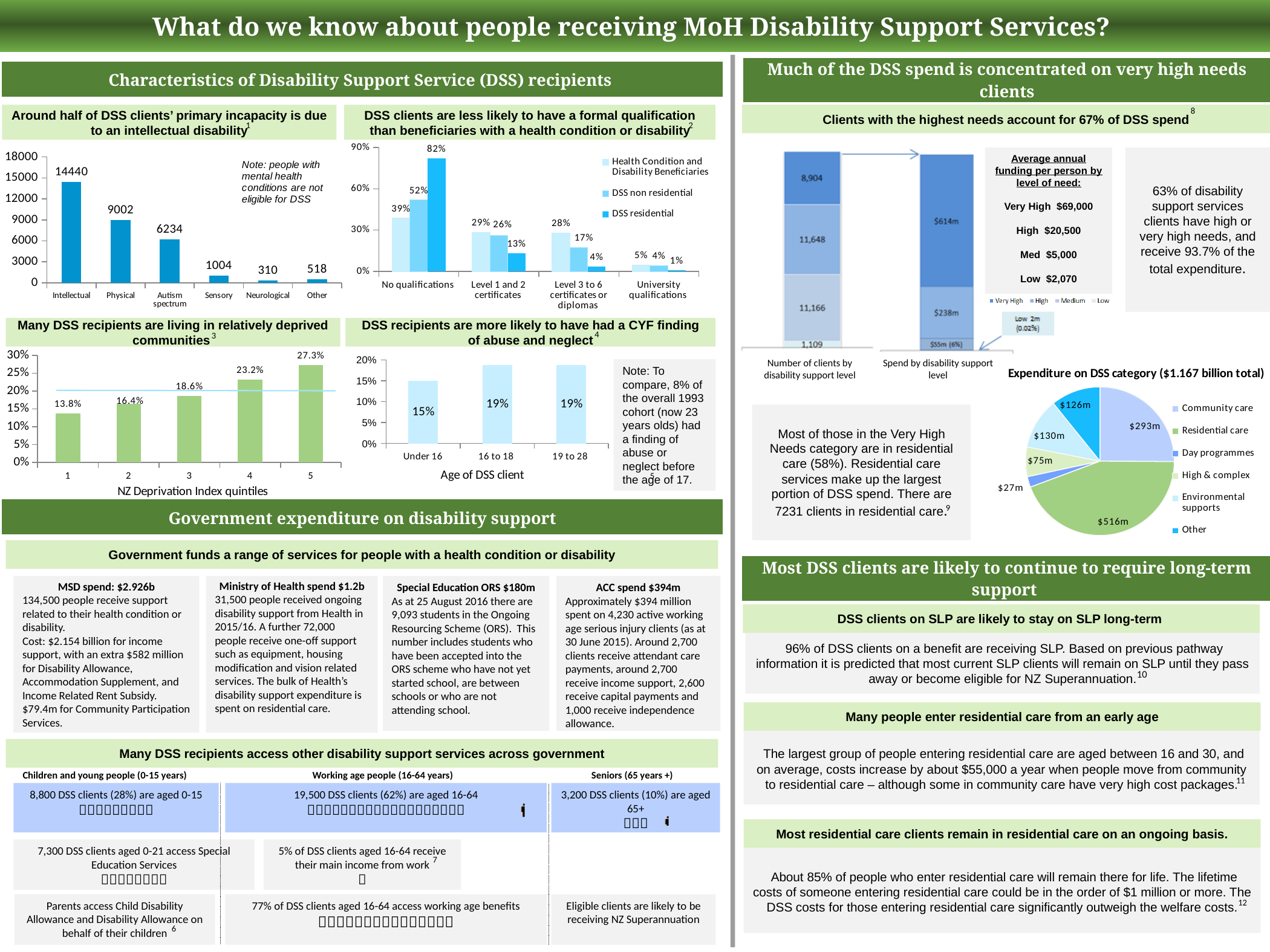
In the chart 'DSS clients are less likely to have a formal qualification', what is the value for DSS non residential clients with Level 3 to 6 certificates or diplomas? 17% How many series does the legend list in the chart 'DSS clients are less likely to have a formal qualification'? 3 What kind of chart is 'Expenditure on DSS category ($1.167 billion total)'? pie chart In the chart 'Around half of DSS clients' primary incapacity is due to an intellectual disability', what is the value for Physical? 9002 In the pie chart 'Expenditure on DSS category', what is the value of the Residential care slice? $516m In the chart 'Many DSS recipients are living in relatively deprived communities', do the values rise or fall from quintile 1 to quintile 5? rise In the chart 'Many DSS recipients are living in relatively deprived communities', what is the value for quintile 5? 27.3% In the stacked bar 'Number of clients by disability support level', what is the value of the Very High segment? 8,904 In the chart 'Around half of DSS clients' primary incapacity is due to an intellectual disability', what is the difference between the Intellectual and Autism spectrum values? 8206 In the chart 'DSS clients are less likely to have a formal qualification', what percentage of DSS residential clients have no qualifications? 82% In the chart 'Around half of DSS clients' primary incapacity is due to an intellectual disability', which category has the lowest value? Neurological In the chart 'DSS recipients are more likely to have had a CYF finding of abuse and neglect', what is the value for clients under 16? 15%